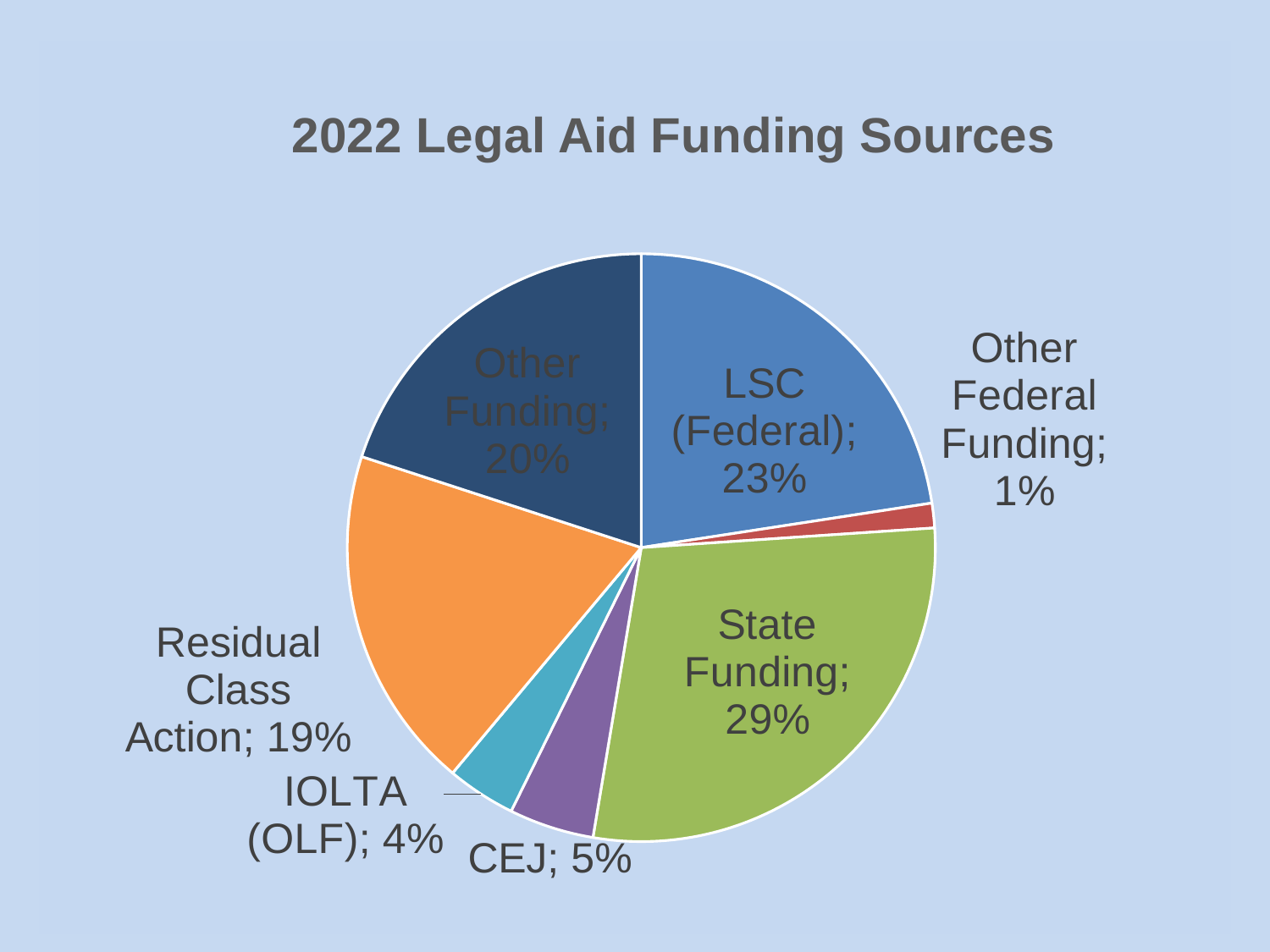
What percentage is shown for IOLTA (OLF)? 4% What is the combined share of LSC (Federal) and Other Federal Funding? 24% What kind of chart is shown on the slide? Pie chart Which is larger, the CEJ slice or the IOLTA (OLF) slice? CEJ What percentage of funding is labelled LSC (Federal)? 23% What share of 2022 legal aid funding comes from State Funding? 29% What share does Residual Class Action represent? 19% How many percentage points larger is State Funding than Other Funding? 9 How many funding sources are shown in the pie chart? 7 What is the title of the chart? 2022 Legal Aid Funding Sources Which funding source has the smallest share of the pie? Other Federal Funding Which funding source has the largest share of the pie? State Funding